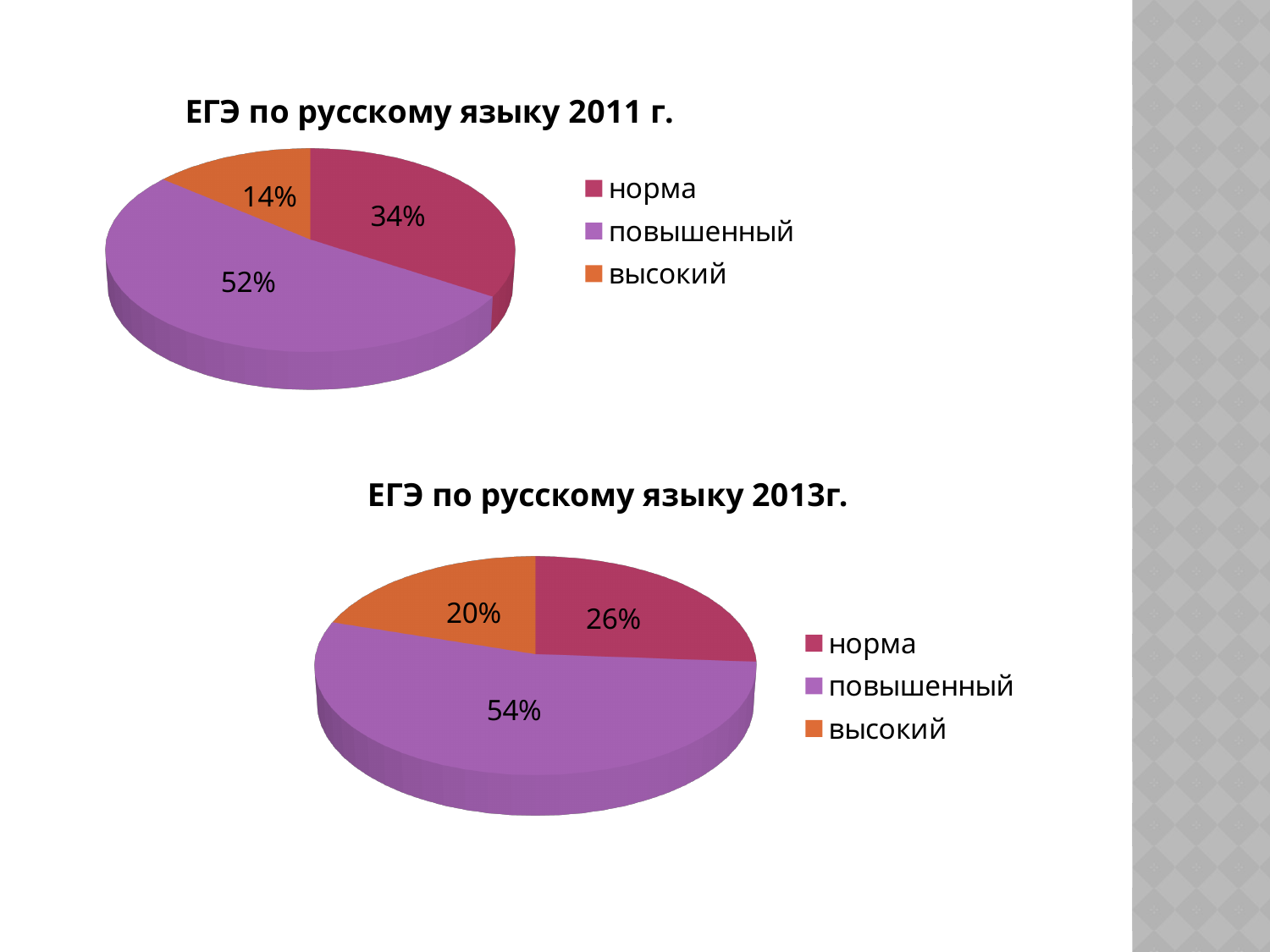
In the chart titled "ЕГЭ по русскому языку 2011 г.", what share does "повышенный" have? 52% In the chart titled "ЕГЭ по русскому языку 2011 г.", which category has the largest slice? повышенный In the chart titled "ЕГЭ по русскому языку 2011 г.", what colour is the "высокий" slice? Orange In the chart titled "ЕГЭ по русскому языку 2013г.", which is larger, "норма" or "высокий"? норма In the chart titled "ЕГЭ по русскому языку 2013г.", what share does "норма" have? 26% In the chart titled "ЕГЭ по русскому языку 2011 г.", what share does "высокий" have? 14% How many slices does the chart titled "ЕГЭ по русскому языку 2013г." have? 3 In the chart titled "ЕГЭ по русскому языку 2013г.", which category has the smallest slice? высокий How many entries does the legend of the chart titled "ЕГЭ по русскому языку 2013г." list? 3 In the chart titled "ЕГЭ по русскому языку 2013г.", what share does "повышенный" have? 54% What kind of chart is the chart titled "ЕГЭ по русскому языку 2011 г."? Pie chart In the chart titled "ЕГЭ по русскому языку 2011 г.", what is the difference between the "норма" and "высокий" shares? 20%